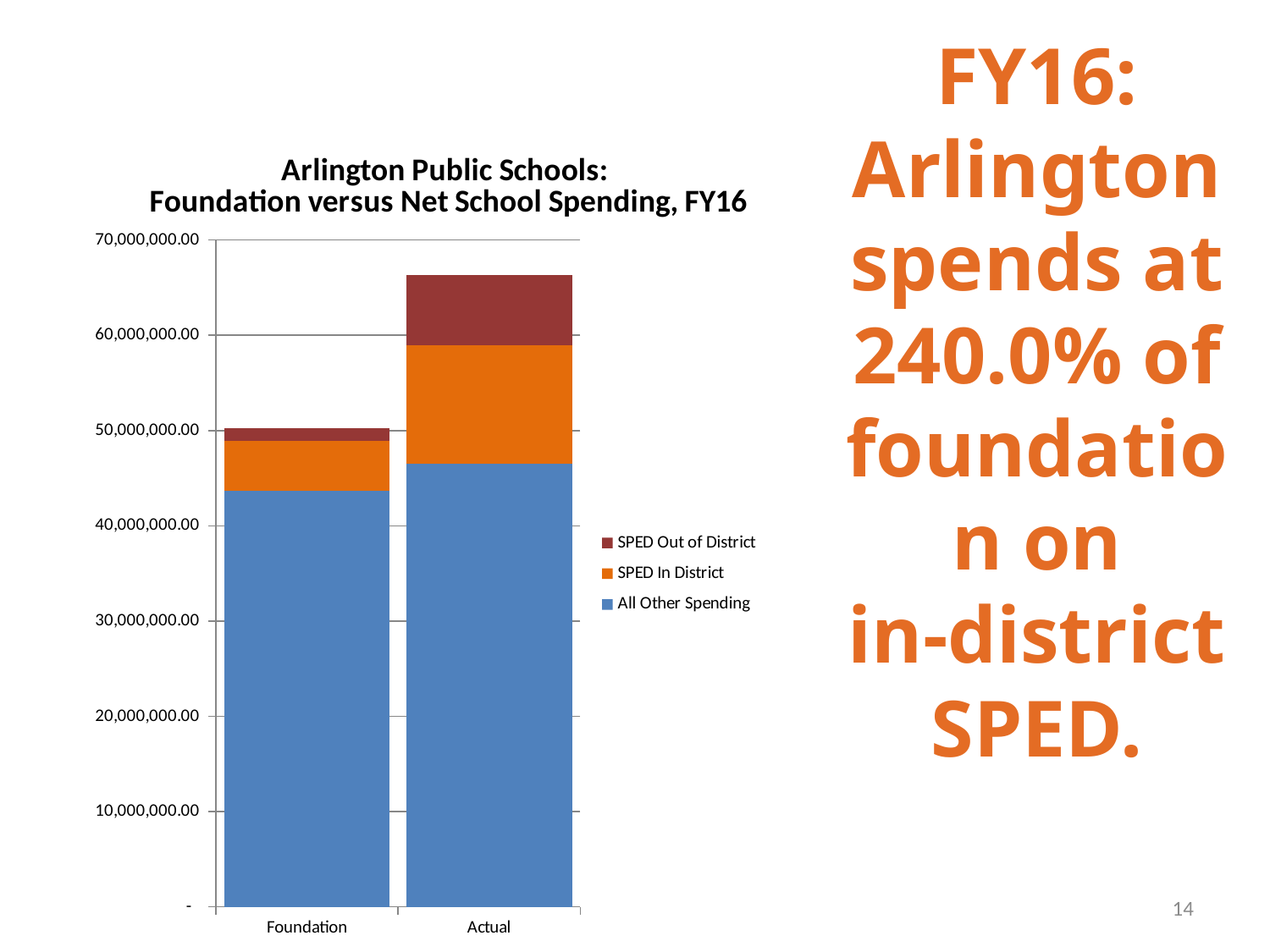
Which category has the larger SPED In District segment, Foundation or Actual? Actual What is the title of the chart? Arlington Public Schools: Foundation versus Net School Spending, FY16 Is the total of the Actual bar greater or less than 60,000,000.00? greater How many series does the chart's legend list? 3 Is the total of the Actual bar greater or less than 70,000,000.00? less Which category has the larger SPED Out of District segment, Foundation or Actual? Actual Which category has the taller stacked bar, Foundation or Actual? Actual Which series is shown in blue in the chart? All Other Spending What kind of chart is shown on the slide? Stacked bar chart Is the All Other Spending value for Foundation greater or less than 40,000,000.00? greater How many categories are shown on the x axis of the chart? 2